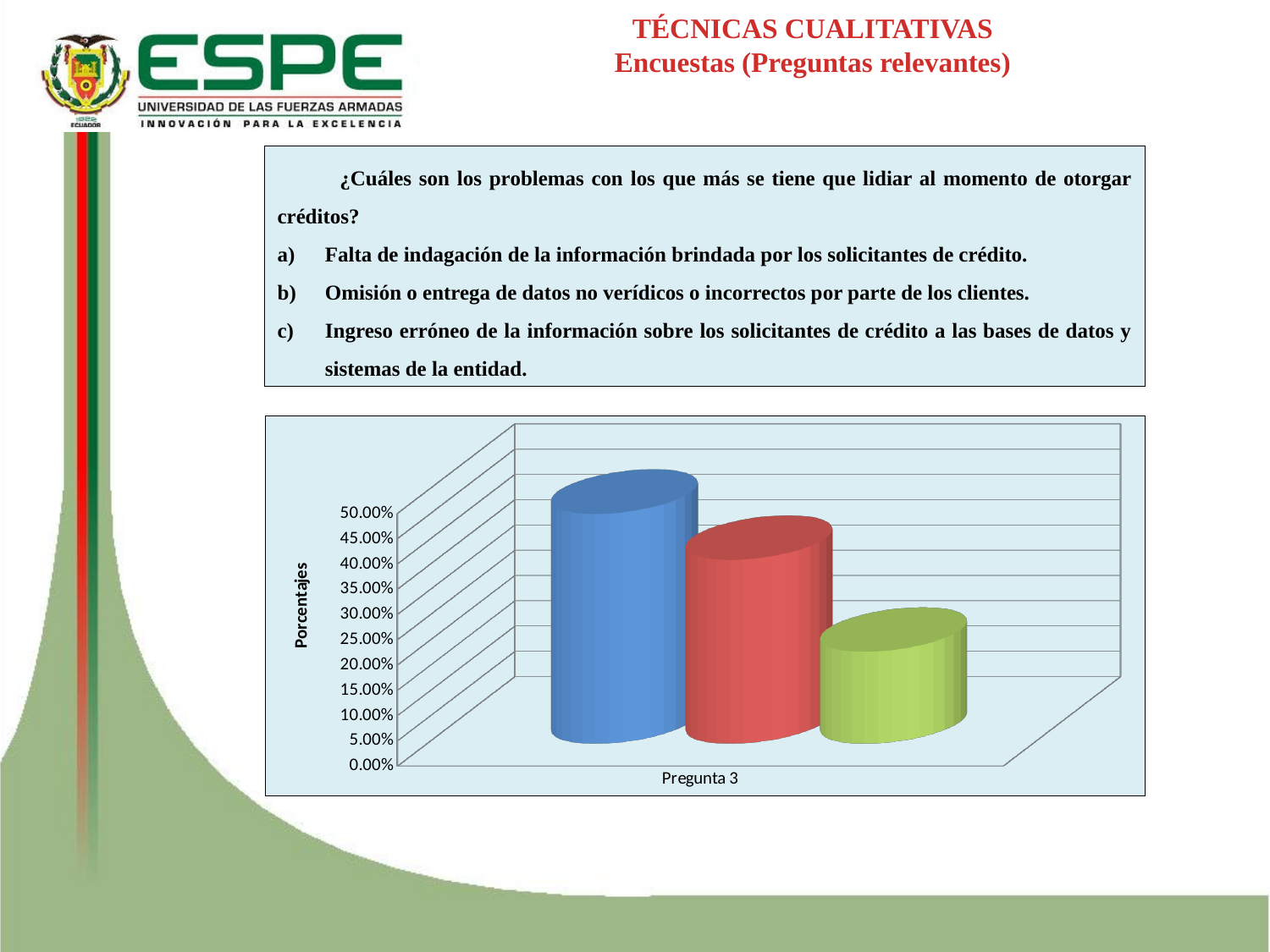
What category label appears on the horizontal axis of the chart? Pregunta 3 What kind of chart is shown on the slide? bar chart How many bars are plotted in the chart? 3 Is the value of the green bar greater or less than 40.00%? less Is the value of the red bar greater or less than 30.00%? greater Which coloured bar is the shortest in the chart? the green bar Is the value of the green bar greater or less than 10.00%? greater What is the highest value shown on the vertical axis of the chart? 50.00% Which is larger, the value of the red bar or the value of the green bar? the red bar What is the title of the vertical axis of the chart? Porcentajes Which coloured bar is the tallest in the chart? the blue bar